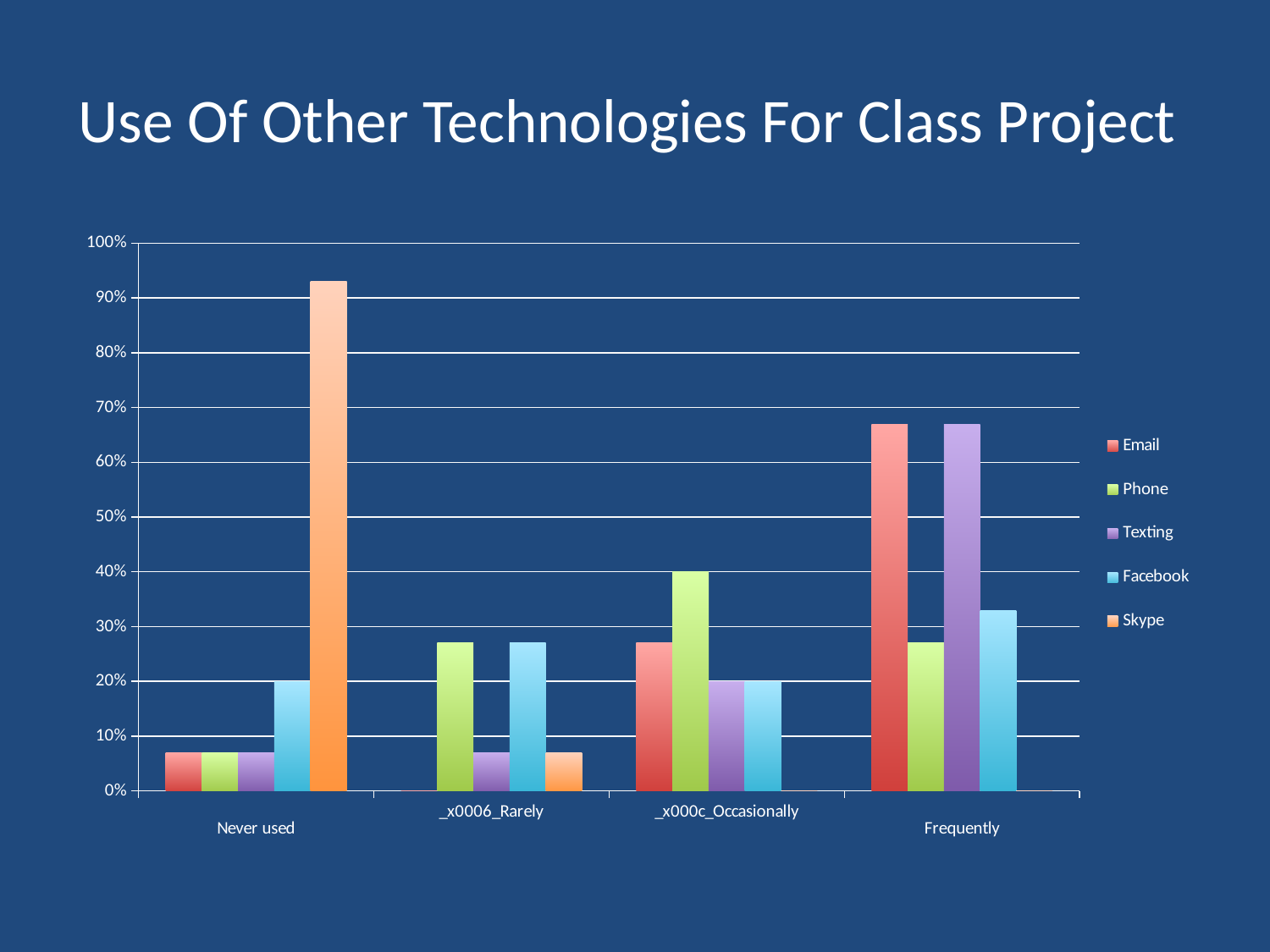
Is the value for Phone in the Rarely category greater or less than 30%? less Which is larger in the Frequently category, Facebook or Phone? Facebook What is the value for Phone in the Occasionally category? 40% Which series has the highest value in the Occasionally category? Phone How many series does the legend list? 5 How many categories are shown on the x axis? 4 Which series has the highest value in the Never used category? Skype Is the value for Skype in the Never used category greater or less than 90%? greater What is the title of the chart? Use Of Other Technologies For Class Project What is the value for Facebook in the Never used category? 20% What type of chart is shown on the slide? bar chart Is the value for Email in the Frequently category greater or less than 60%? greater